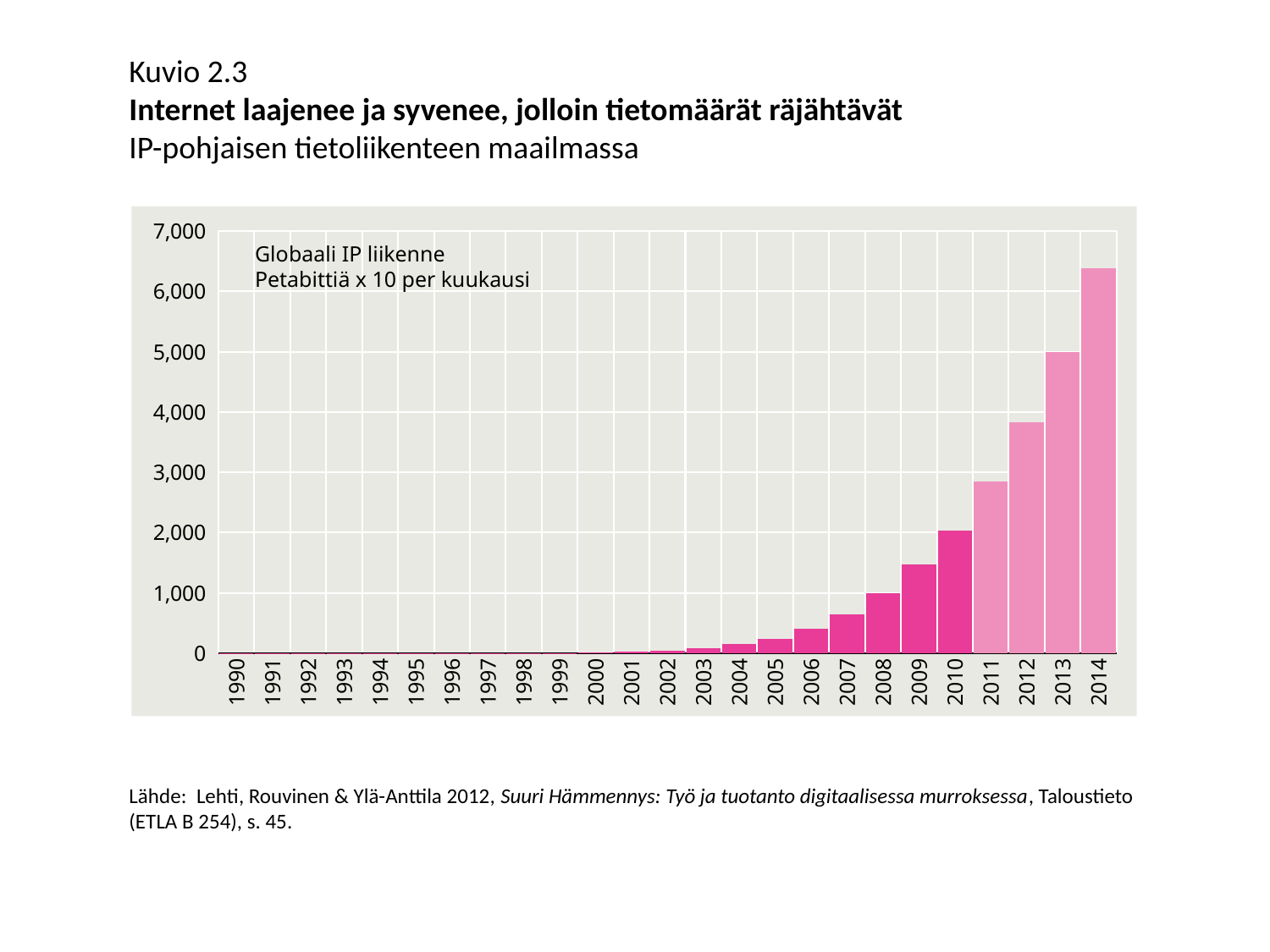
Is the value for 2014 greater or less than 6,000? greater Which year has the highest value in the chart? 2014 Is the value for 2011 greater or less than 2,000? greater What kind of chart is shown on the slide? bar chart What unit is stated in the text inside the chart area? Petabittiä x 10 per kuukausi How many years are shown on the x axis of the chart? 25 Do the values generally rise or fall from 1990 to 2014? rise What is the label written inside the chart area above the unit? Globaali IP liikenne Is the value for 2007 greater or less than 1,000? less Which year has the larger value, 2012 or 2013? 2013